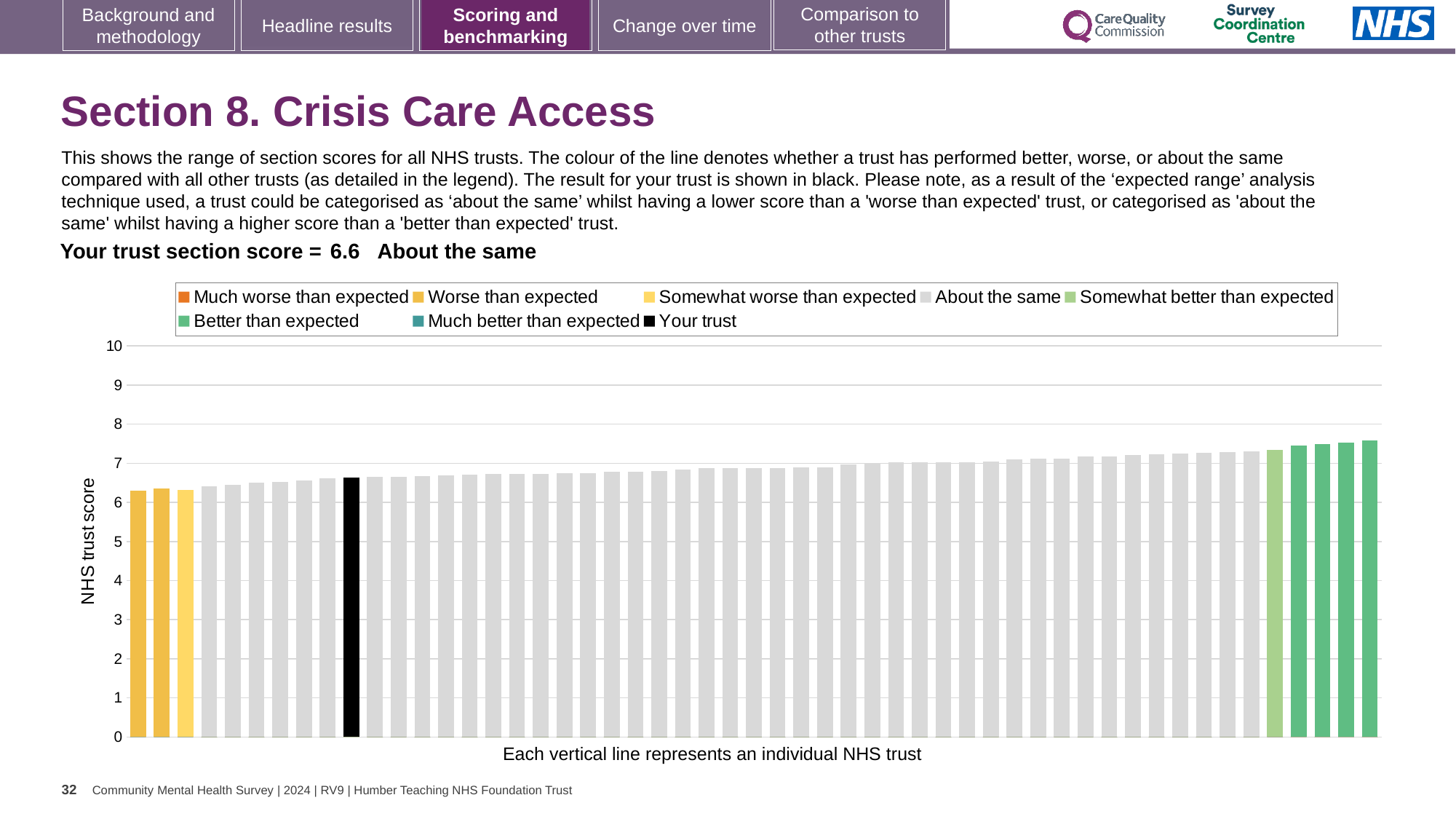
What is the label on the vertical axis of the chart? NHS trust score What kind of chart is shown on the slide? bar chart Is the value of the black bar (your trust) greater or less than 7? less Which category is your trust's section score placed in? About the same Is the value of the tallest bar greater or less than 7? greater Do the bar values rise or fall from left to right along the x axis? rise How many bars are coloured in the 'Worse than expected' colour? 2 Is the value of the shortest bar greater or less than 6? greater What is the highest value shown on the vertical axis? 10 What is the section score for your trust shown on the slide? 6.6 How many entries does the chart legend list? 8